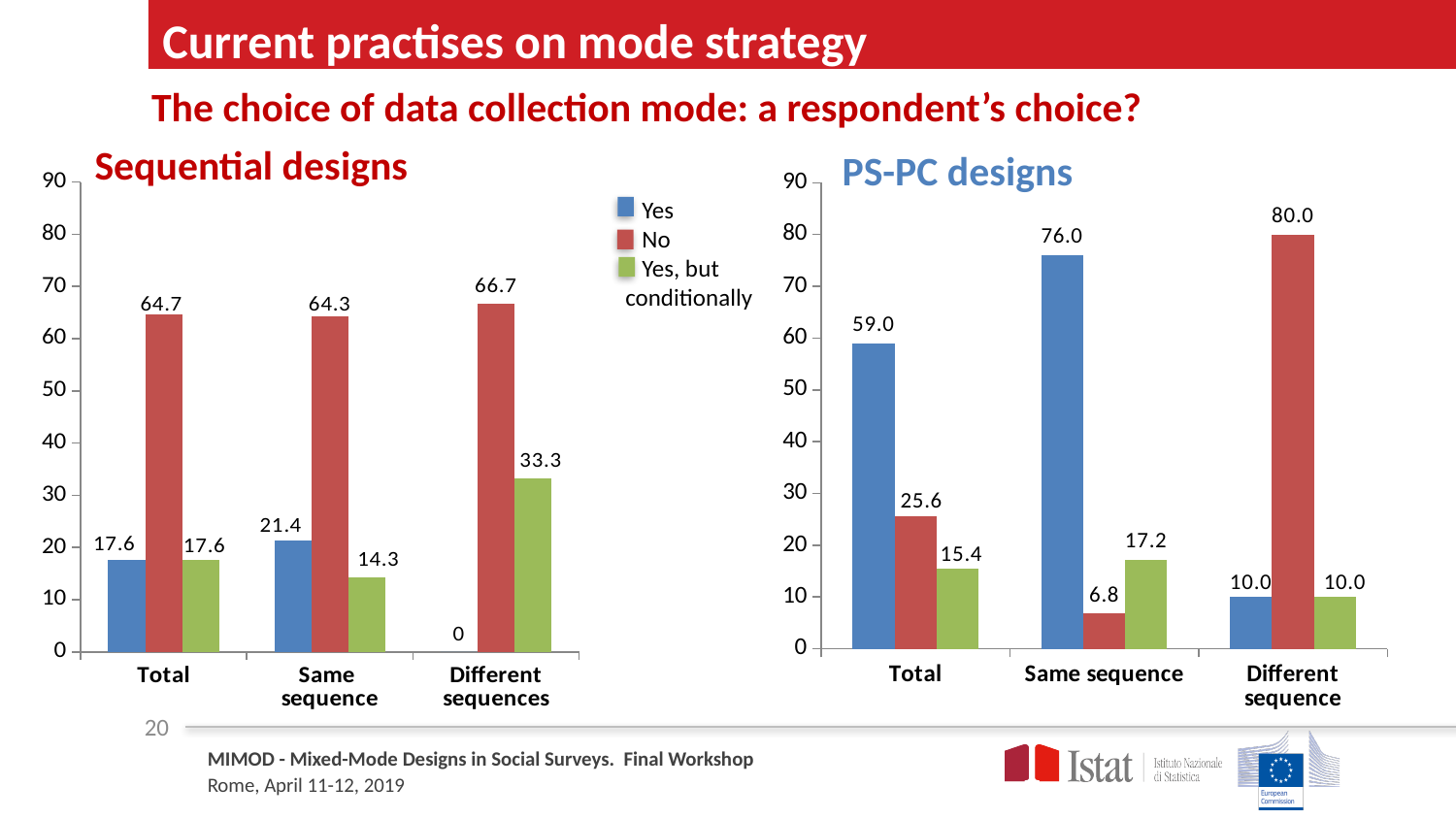
In the PS-PC designs chart, what is the value for No in the Different sequence category? 80.0 How many categories are shown on the x axis of the PS-PC designs chart? 3 In the Sequential designs chart, what is the value for No in the Total category? 64.7 In the Sequential designs chart, which is larger in the Same sequence category: Yes or Yes, but conditionally? Yes In the Sequential designs chart, what is the value for Yes, but conditionally in the Different sequences category? 33.3 In the PS-PC designs chart, what is the value for Yes in the Same sequence category? 76.0 In the PS-PC designs chart, which category has the highest value for No? Different sequence What type of chart is the Sequential designs chart? Bar chart In the PS-PC designs chart, what is the difference between the Yes value and the No value in the Total category? 33.4 How many series does the legend list? 3 In the PS-PC designs chart, which category has the lowest value for Yes? Different sequence In the Sequential designs chart, what is the value for Yes in the Different sequences category? 0